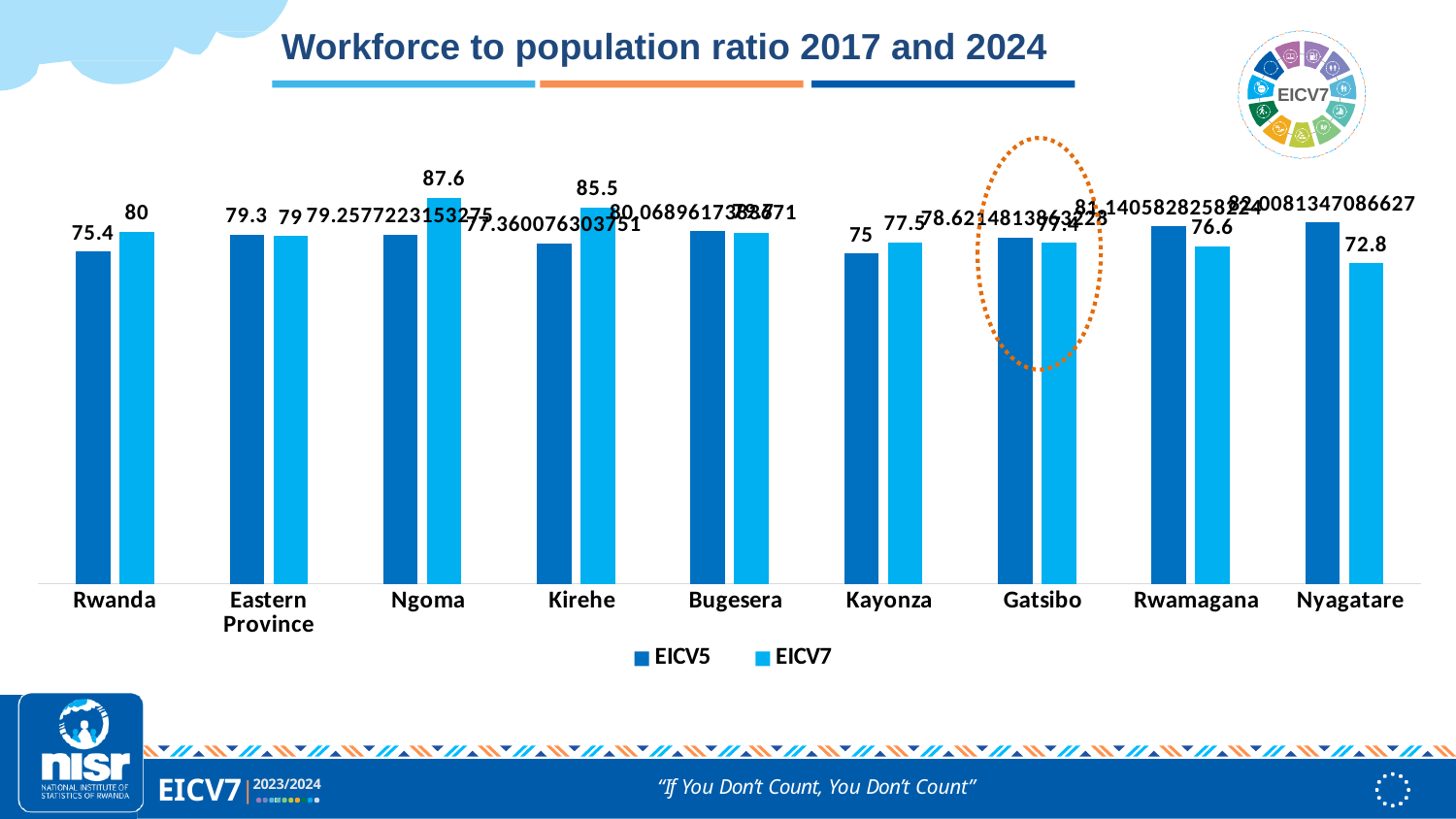
For Nyagatare, which is larger: the EICV5 value or the EICV7 value? EICV5 What is the EICV7 value for Nyagatare? 72.8 How many categories are shown on the x axis? 9 What kind of chart is shown on the slide? Bar chart What is the EICV5 value for Kayonza? 75 What is the EICV5 value for Rwanda? 75.4 Which category has the lowest EICV7 value? Nyagatare What is the EICV7 value for Rwanda? 80 How many series does the legend list? 2 Which category has the highest EICV7 value? Ngoma What is the difference between the EICV7 and EICV5 values for Rwanda? 4.6 What is the EICV7 value for Ngoma? 87.6